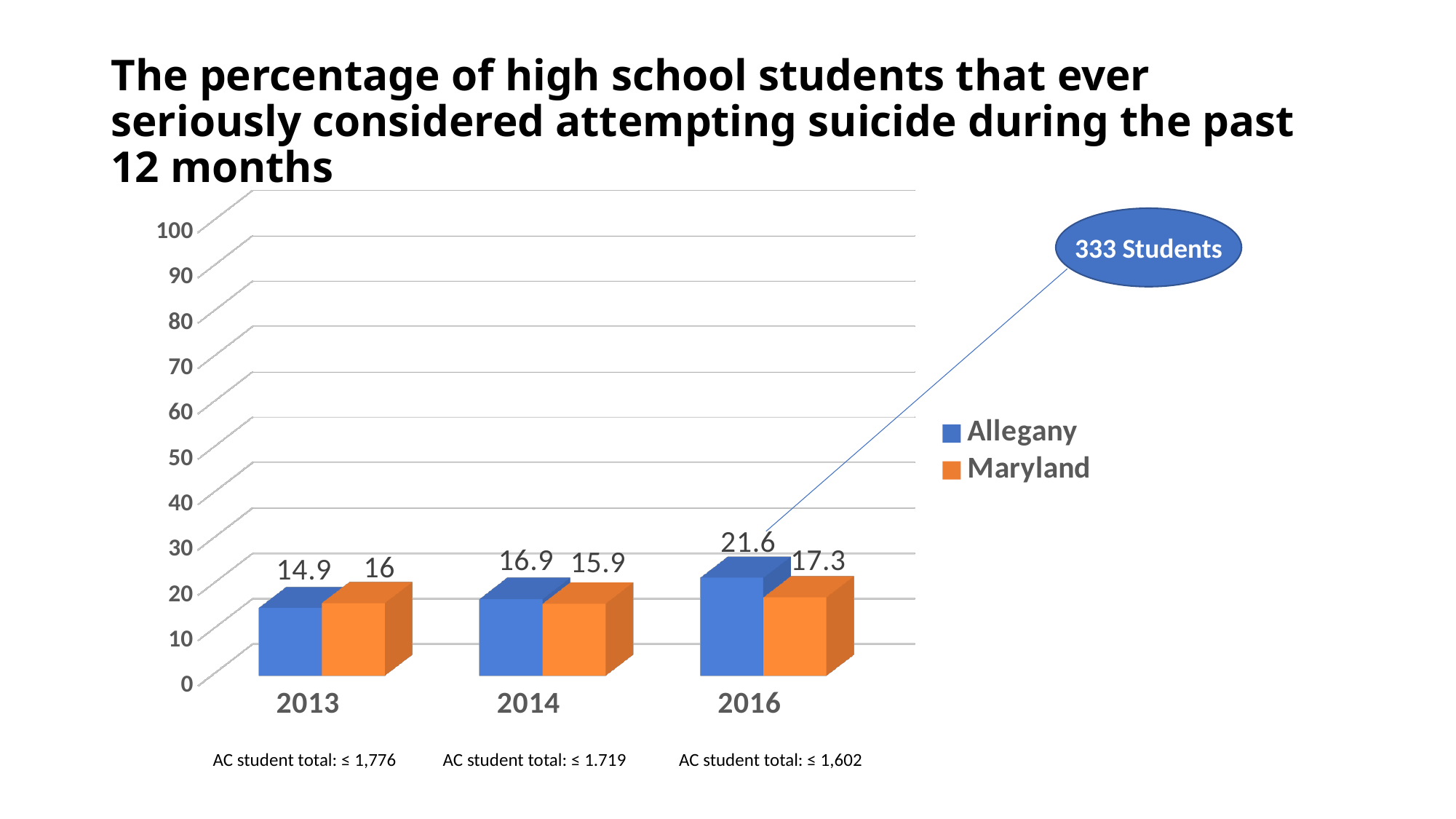
How many years are shown on the x axis? 3 Does the Allegany value rise or fall from 2013 to 2016? Rise In which year is the Maryland value lowest? 2014 Is the value for Allegany in 2016 greater or less than 20? greater Which is larger in 2013, the Allegany value or the Maryland value? Maryland What is the difference between the Allegany and Maryland values in 2016? 4.3 What kind of chart is shown on the slide? Bar chart What is the value for Allegany in 2013? 14.9 What is the value for Maryland in 2016? 17.3 What is the value for Allegany in 2014? 16.9 In which year is the Allegany value highest? 2016 How many series does the legend list? 2